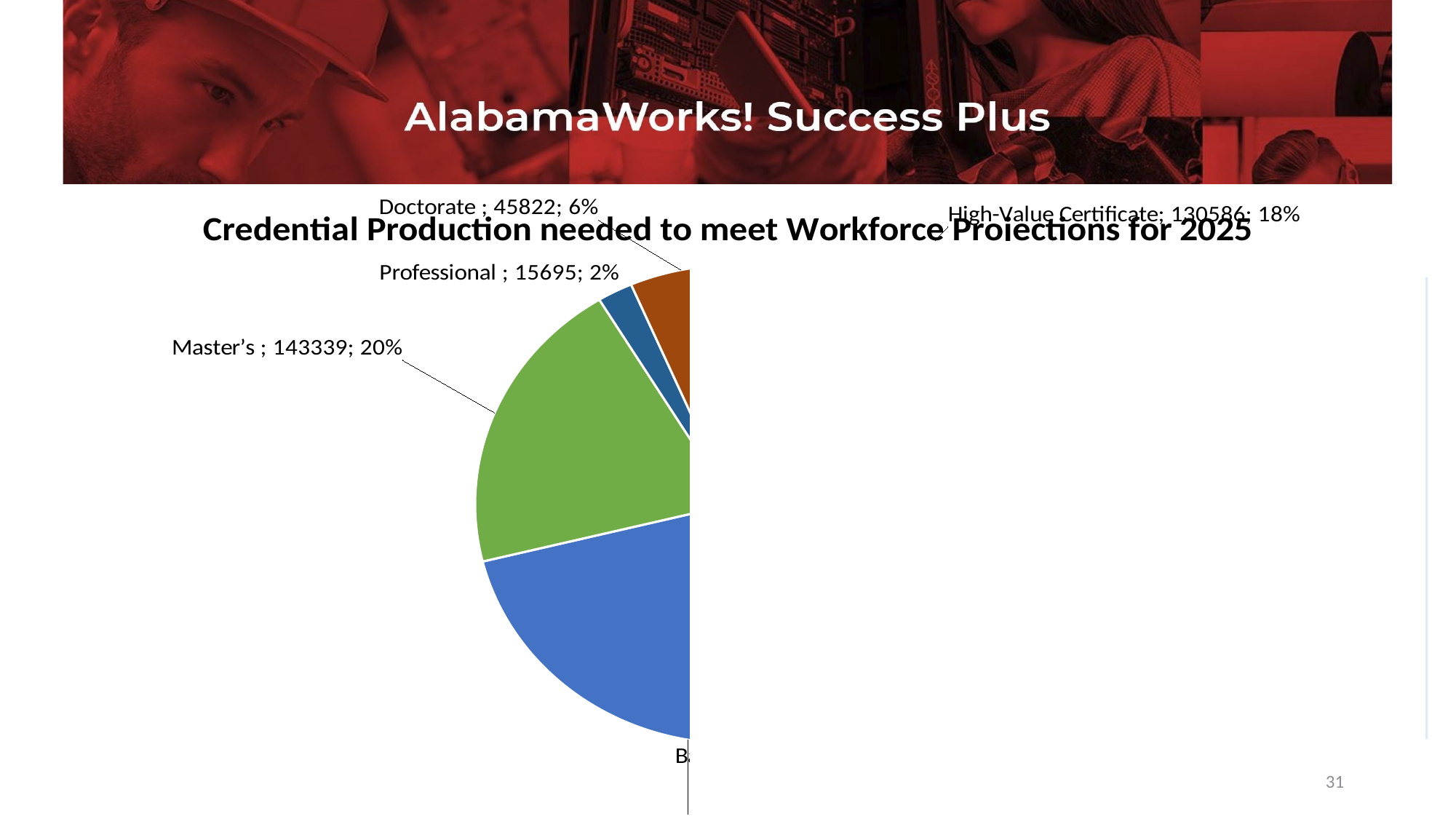
What value is shown for Doctorate in the pie chart? 45822 What is the difference between the Doctorate value and the Professional value? 30127 What kind of chart is shown on the slide? Pie chart What percentage share does the Doctorate slice have? 6% Which is larger, the value for Master's or the value for High-Value Certificate? Master's What percentage share does the Master's slice have? 20% What is the title of the chart on the slide? Credential Production needed to meet Workforce Projections for 2025 What is the difference between the Master's value and the High-Value Certificate value? 12753 What value is shown for Professional in the pie chart? 15695 What percentage share does the High-Value Certificate slice have? 18% What value is shown for Master's in the pie chart? 143339 Which is larger, the value for Doctorate or the value for Professional? Doctorate